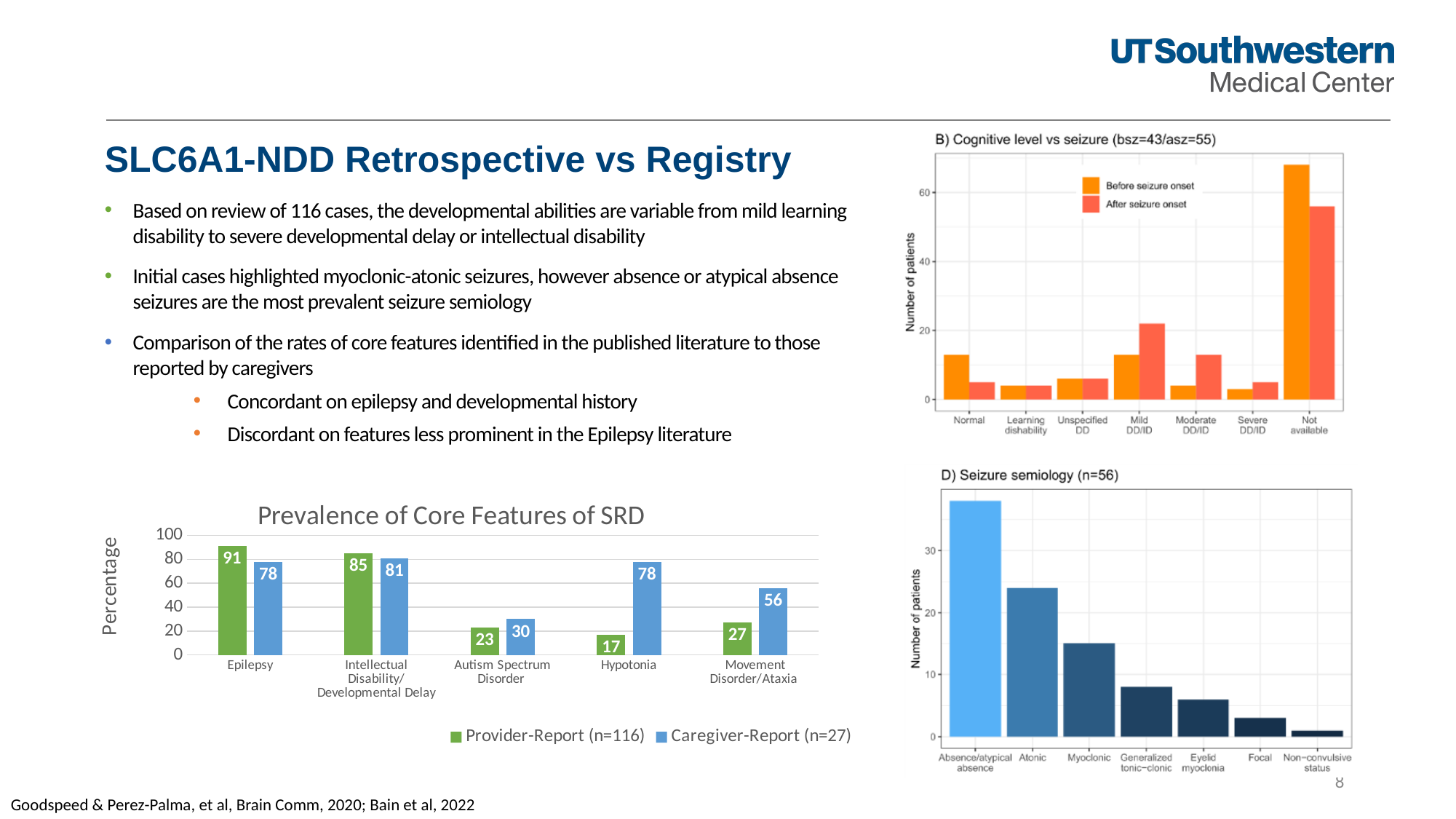
In the 'Prevalence of Core Features of SRD' chart, which category has the lowest Provider-Report value? Hypotonia In the 'Prevalence of Core Features of SRD' chart, what is the difference between the Caregiver-Report and Provider-Report values for Hypotonia? 61 In the 'Prevalence of Core Features of SRD' chart, what is the Provider-Report value for Epilepsy? 91 In the 'Prevalence of Core Features of SRD' chart, which is larger for Movement Disorder/Ataxia: the Provider-Report value or the Caregiver-Report value? Caregiver-Report In the 'B) Cognitive level vs seizure' chart, is the 'Before seizure onset' value for Not available greater or less than 60? greater How many categories are shown on the x axis of the 'Prevalence of Core Features of SRD' chart? 5 In the 'Prevalence of Core Features of SRD' chart, which category has the highest Caregiver-Report value? Intellectual Disability/Developmental Delay In the 'Prevalence of Core Features of SRD' chart, what is the Caregiver-Report value for Hypotonia? 78 What kind of chart is 'D) Seizure semiology (n=56)'? Bar chart In the 'D) Seizure semiology (n=56)' chart, do the bar values rise or fall from left to right along the x axis? Fall In the 'D) Seizure semiology (n=56)' chart, is the value for Absence/atypical absence greater or less than 30? greater How many series does the legend of the 'Prevalence of Core Features of SRD' chart list? 2